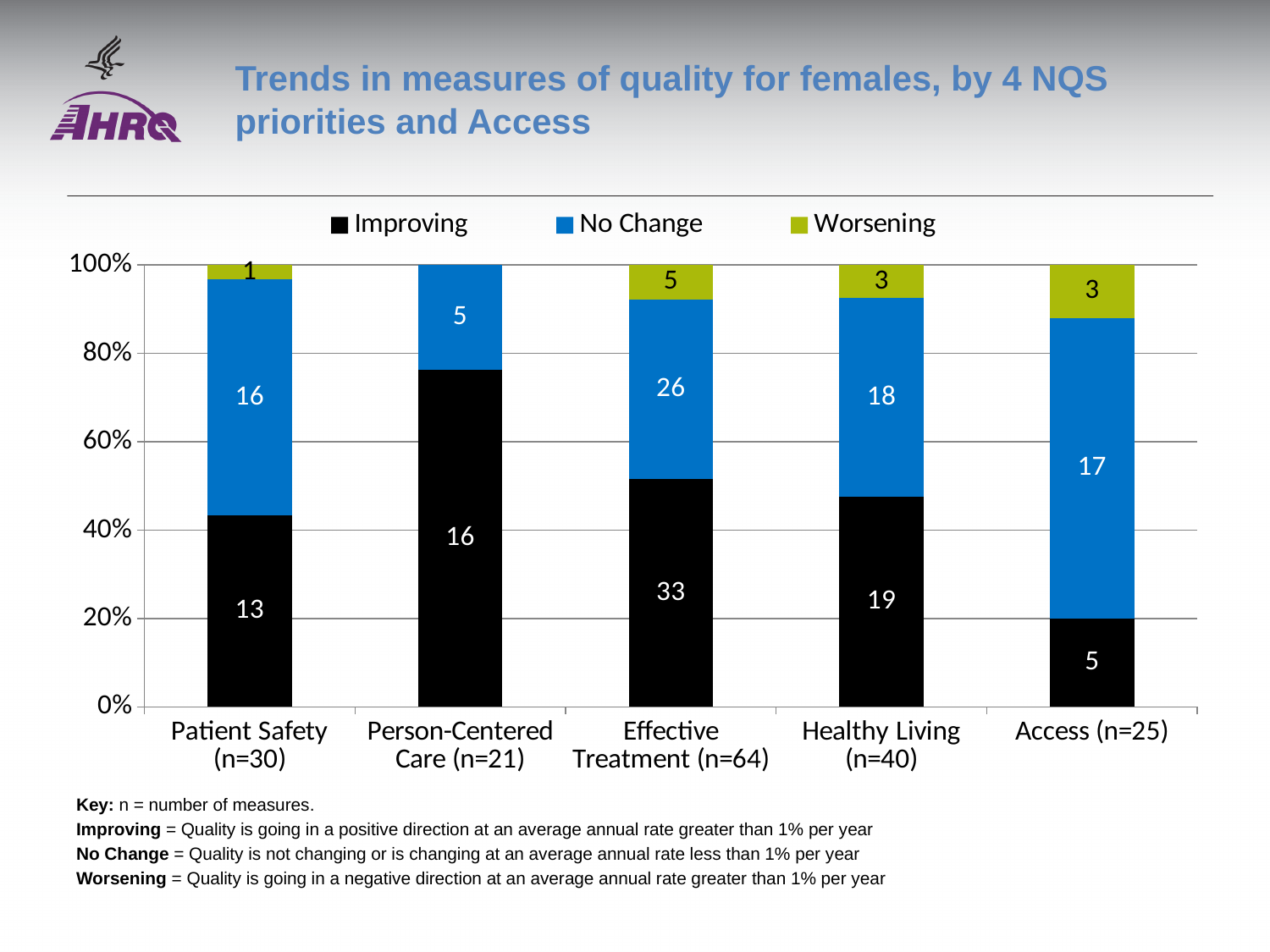
What is the total of the labelled values in the Effective Treatment (n=64) bar? 64 What is the difference between the Improving and No Change values for Healthy Living (n=40)? 1 What is the No Change value for Access (n=25)? 17 Which category has the highest Improving value? Effective Treatment (n=64) Which category has the lowest Improving value? Access (n=25) Which is larger for Patient Safety (n=30): the Improving value or the No Change value? No Change What is the Worsening value for Patient Safety (n=30)? 1 What is the Improving value for Effective Treatment (n=64)? 33 How many categories are shown on the x axis? 5 How many series does the legend list? 3 What is the No Change value for Person-Centered Care (n=21)? 5 What kind of chart is shown on the slide? Stacked bar chart